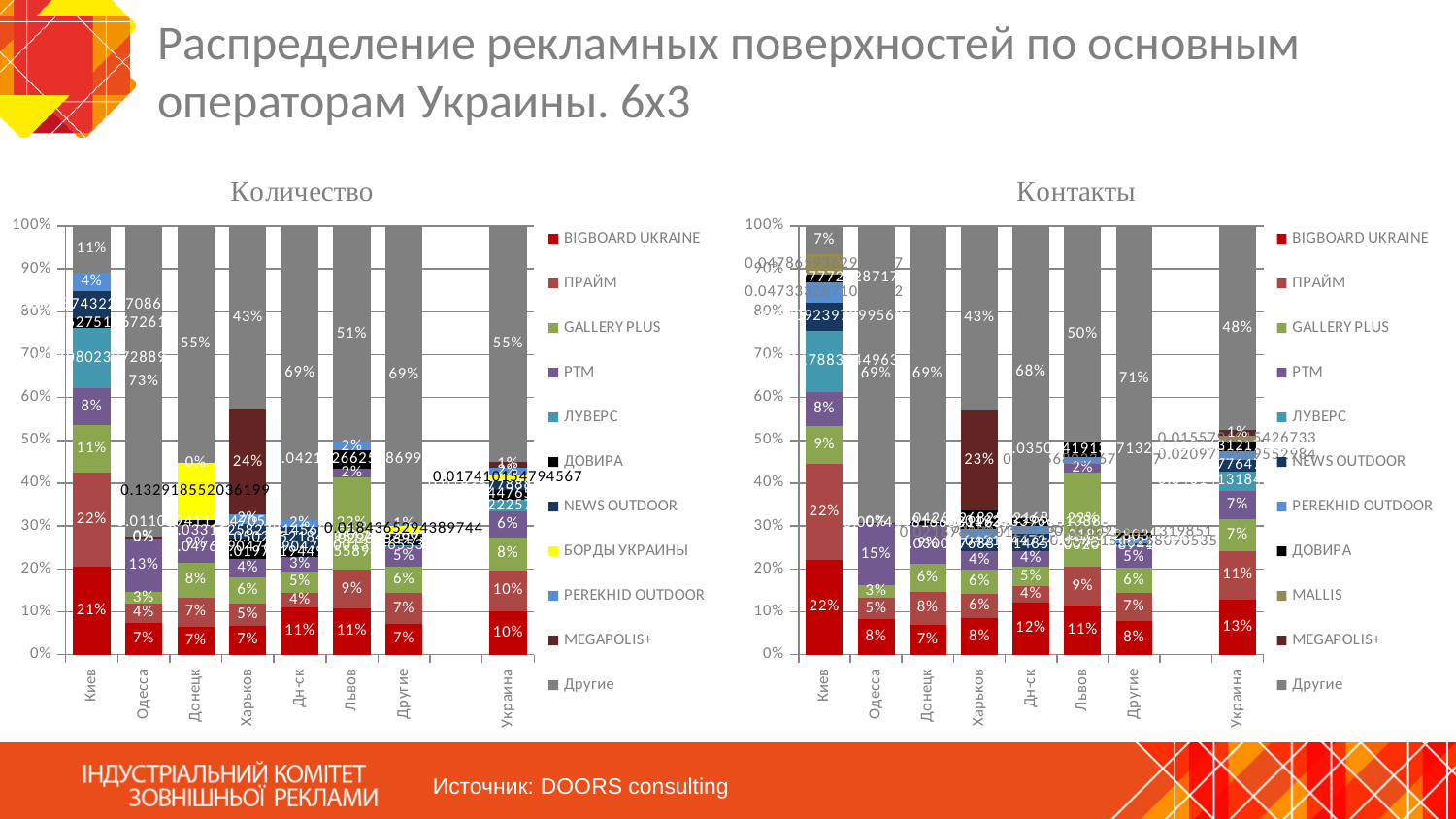
In the "Количество" chart, which is larger: the Другие value for Львов or for Дн-ск? Дн-ск In the "Контакты" chart, what is the value of BIGBOARD UKRAINE for Украина? 13% In the "Контакты" chart, what is the difference between the Другие values for Другие and Харьков? 28% How many categories are shown on the x axis of the "Контакты" chart? 8 In the "Контакты" chart, which category has the lowest value for Другие? Киев What type of chart is the "Количество" chart? stacked bar chart In the "Количество" chart, what is the value of Другие for Одесса? 73% How many series does the legend of the "Количество" chart list? 11 In the "Контакты" chart, what is the value of Другие for Украина? 48% In the "Количество" chart, what is the value of BIGBOARD UKRAINE for Киев? 21% In the "Количество" chart, what is the value of MEGAPOLIS+ for Харьков? 24% In the "Количество" chart, which category has the highest value for Другие? Одесса